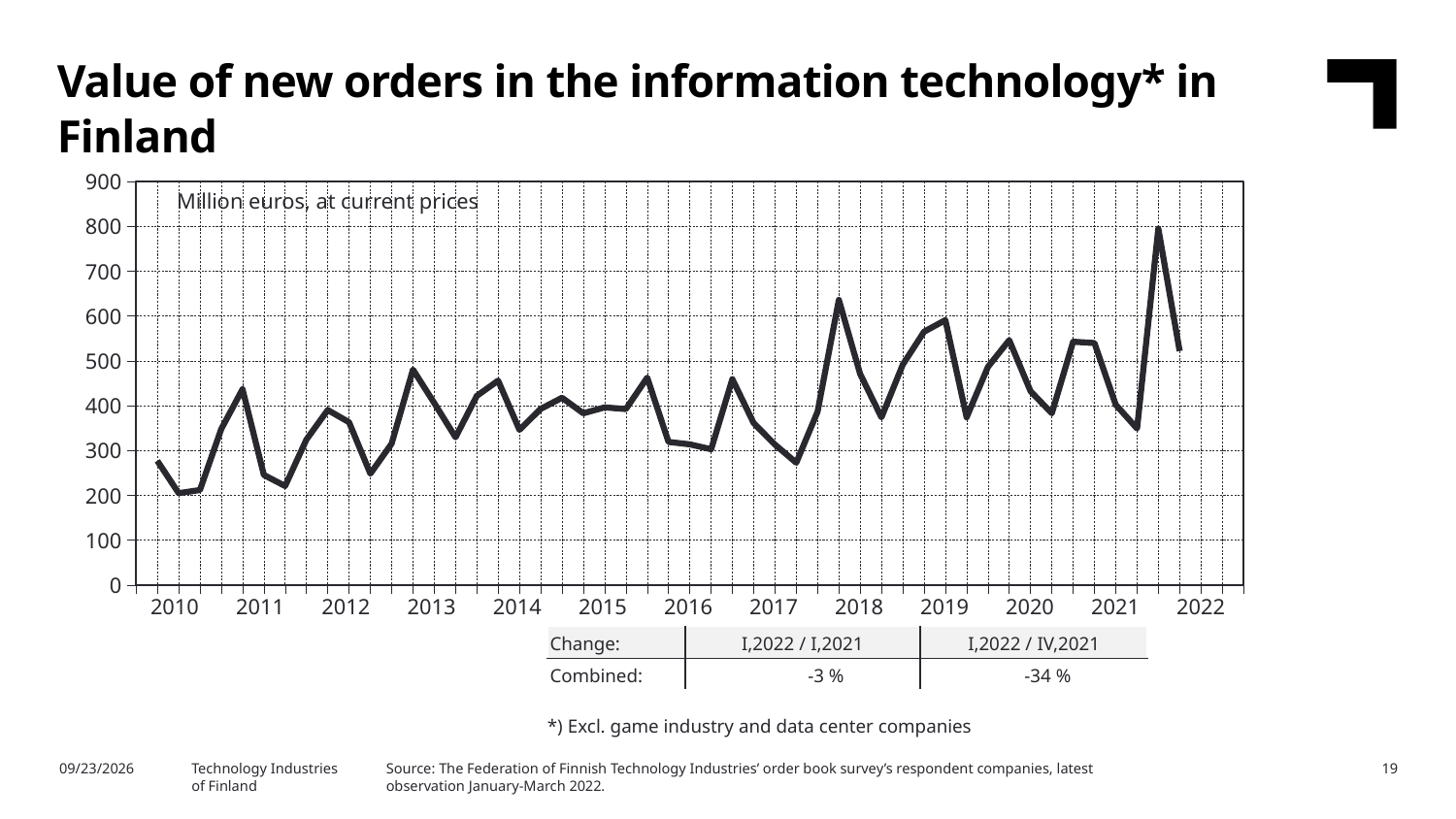
What kind of chart is shown on the slide? line chart What is the combined change for I,2022 / IV,2021 shown in the table below the chart? -34 % Is the peak of the line in 2018 greater or less than 500? greater What is the combined change for I,2022 / I,2021 shown in the table below the chart? -3 % Is the value at the start of 2017 greater or less than 400? less In which year does the line reach its highest peak? 2021 In which year does the line reach its lowest point? 2010 What is the title of the chart? Value of new orders in the information technology* in Finland In what unit are the values on the chart expressed, according to the label inside the plot area? Million euros, at current prices Is the lowest point of the line, in 2010, greater or less than 300? less How many year labels are shown on the x axis? 13